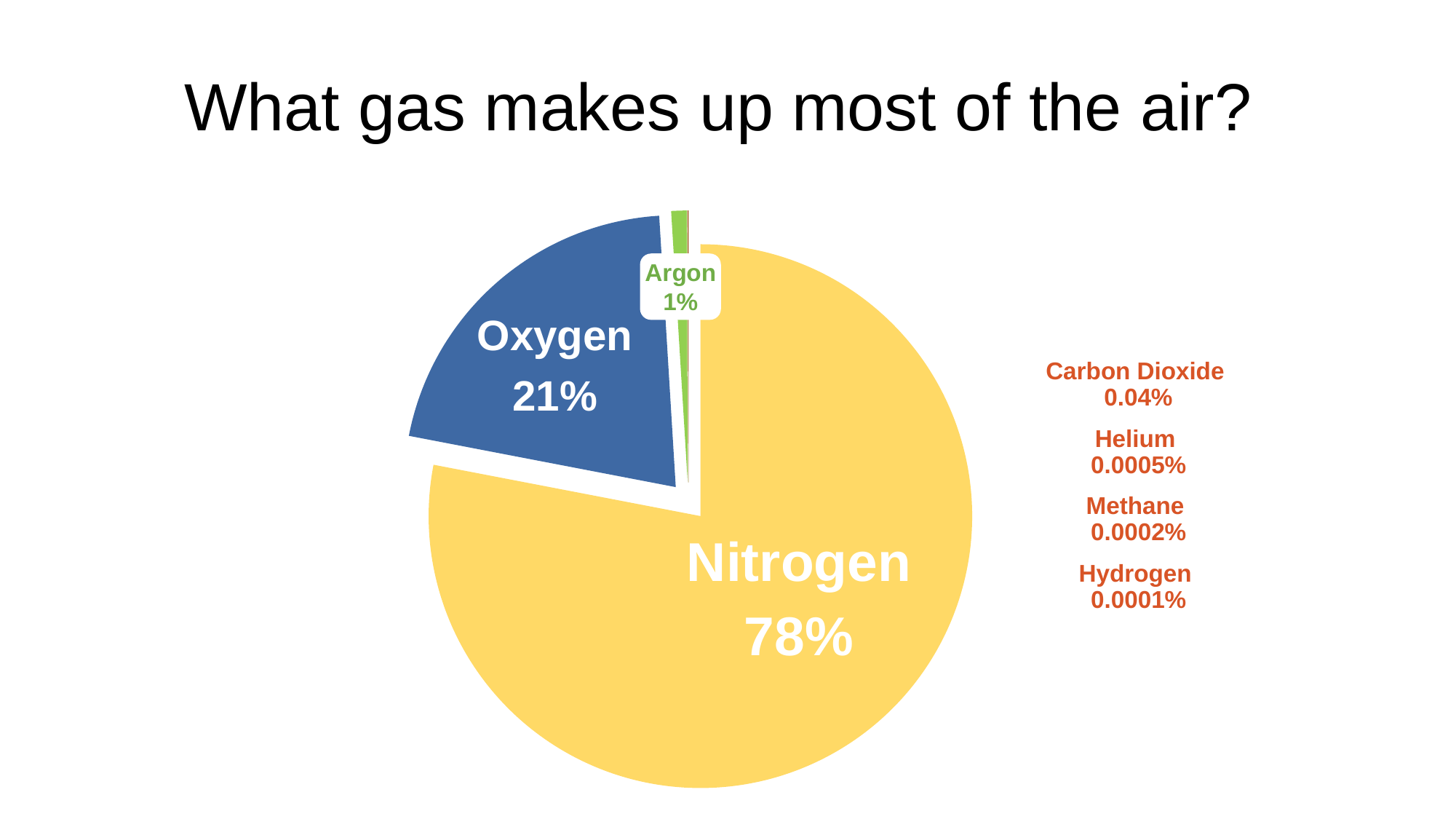
Which of the three labelled slices in the pie chart is the smallest? Argon What percentage of the air is Argon according to the pie chart? 1% Which gas has the largest slice in the pie chart? Nitrogen What percentage is listed for Carbon Dioxide in the text beside the pie chart? 0.04% What colour is the Nitrogen slice in the pie chart? yellow What is the title of the slide containing the pie chart? What gas makes up most of the air? How many labelled slices does the pie chart have? 3 What percentage of the air is Oxygen according to the pie chart? 21% What kind of chart is shown on the slide? pie chart What percentage of the air is Nitrogen according to the pie chart? 78% Which slice is larger, Oxygen or Argon? Oxygen What is the difference in percentage points between the Nitrogen and Oxygen slices? 57